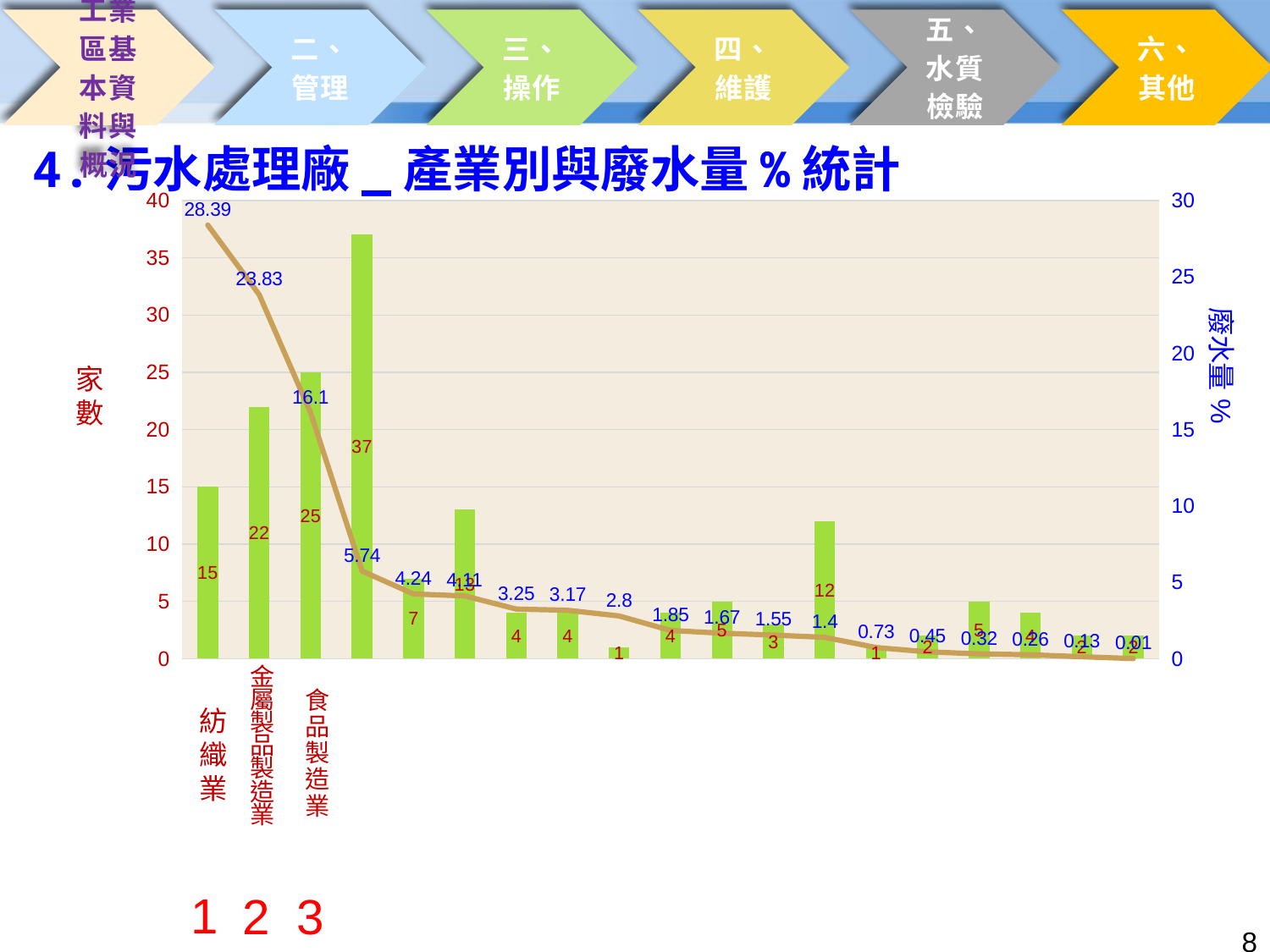
Which labeled industry has the highest wastewater volume percentage? 紡織業 Which has more plants, 食品製造業 or 金屬製品製造業? 食品製造業 How many more plants does 金屬製品製造業 have than 紡織業? 7 How many bars (industry categories) are plotted in the chart? 19 What is the largest number of plants shown by any bar in the chart? 37 What is the number of plants (家數) for 食品製造業? 25 What is the wastewater volume percentage (廢水量%) for 紡織業? 28.39 What is the number of plants (家數) for 金屬製品製造業? 22 Does the wastewater volume percentage line rise or fall from left to right across the chart? fall What is the title of the chart on the slide? 4. 污水處理廠_產業別與廢水量%統計 What is the number of plants (家數) for 紡織業? 15 What is the wastewater volume percentage (廢水量%) for 食品製造業? 16.1